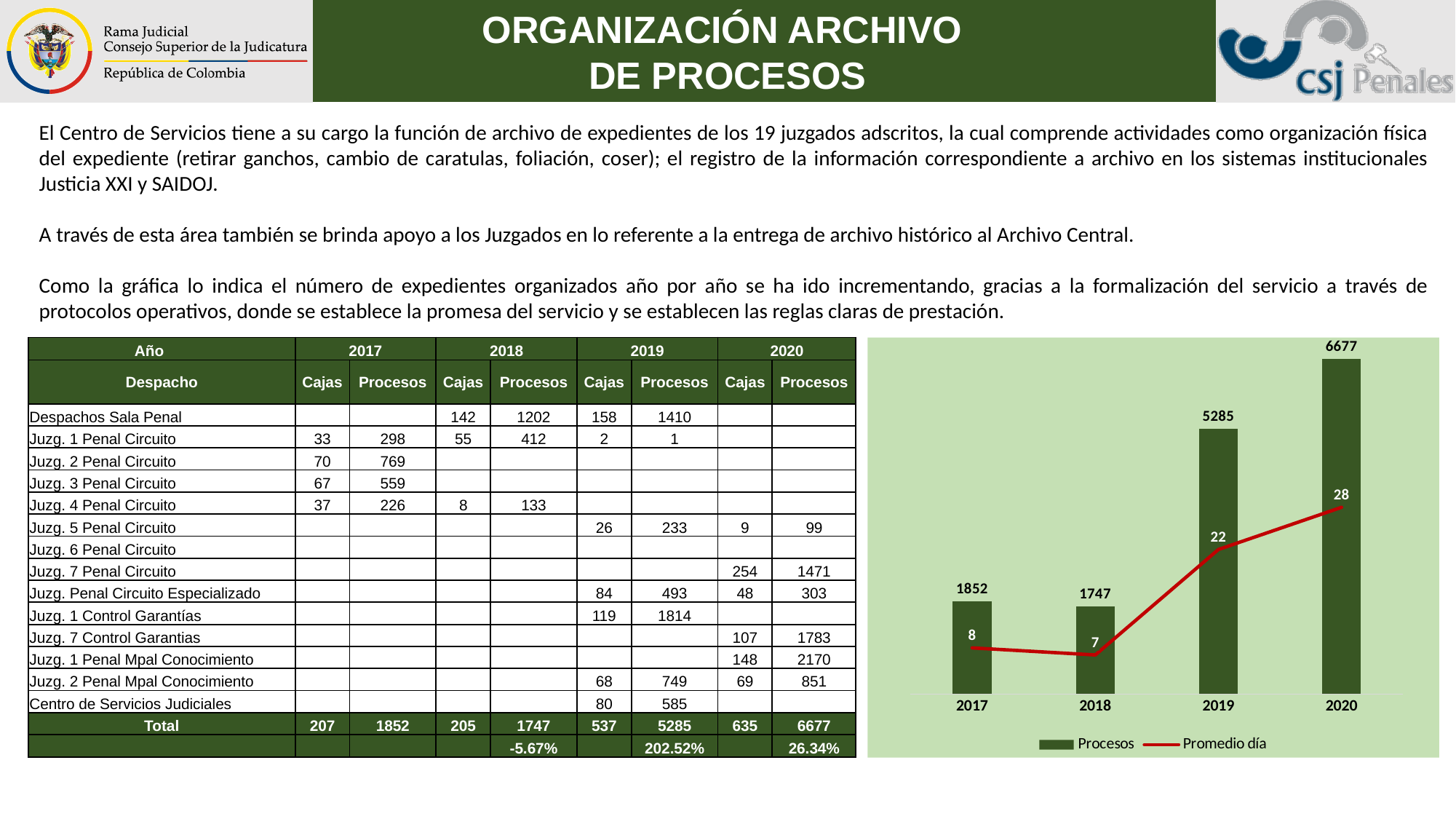
Which year has the lowest Promedio día value in the chart? 2018 What is the value of Procesos for 2019 in the chart? 5285 Does the Promedio día line rise or fall from 2018 to 2020 in the chart? Rise How many years are shown on the x axis of the chart? 4 Which is larger in the chart, the Procesos value for 2017 or for 2018? 2017 What are the two series named in the chart legend? Procesos and Promedio día Which year has the highest Procesos value in the chart? 2020 What is the difference between the Procesos values for 2020 and 2019 in the chart? 1392 How many series does the chart legend list? 2 What is the Promedio día value for 2020 in the chart? 28 What kind of chart is shown on the slide? Combined bar and line chart What is the value of Procesos for 2017 in the chart? 1852